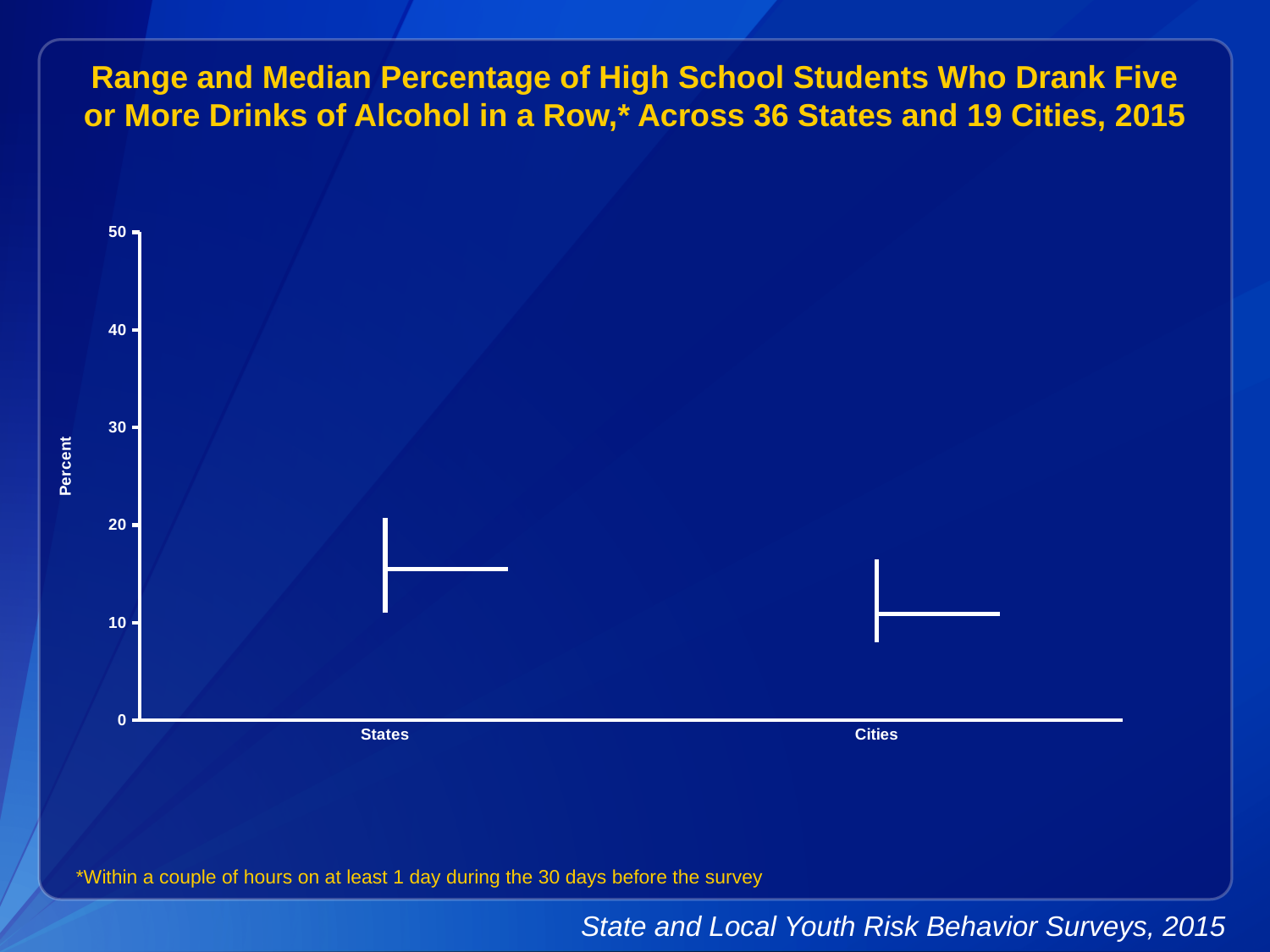
Is the median value for States greater or less than 10? greater Is the median value for Cities greater or less than 20? less What is the label of the y axis? Percent Is the lowest value in the range for Cities greater or less than 10? less Which category has the higher top of its range, States or Cities? States What are the two categories shown on the x axis? States and Cities Which category has the higher median percentage, States or Cities? States How many categories are shown on the x axis of the chart? 2 What is the highest value shown on the y axis? 50 Which category has the lower bottom of its range, States or Cities? Cities